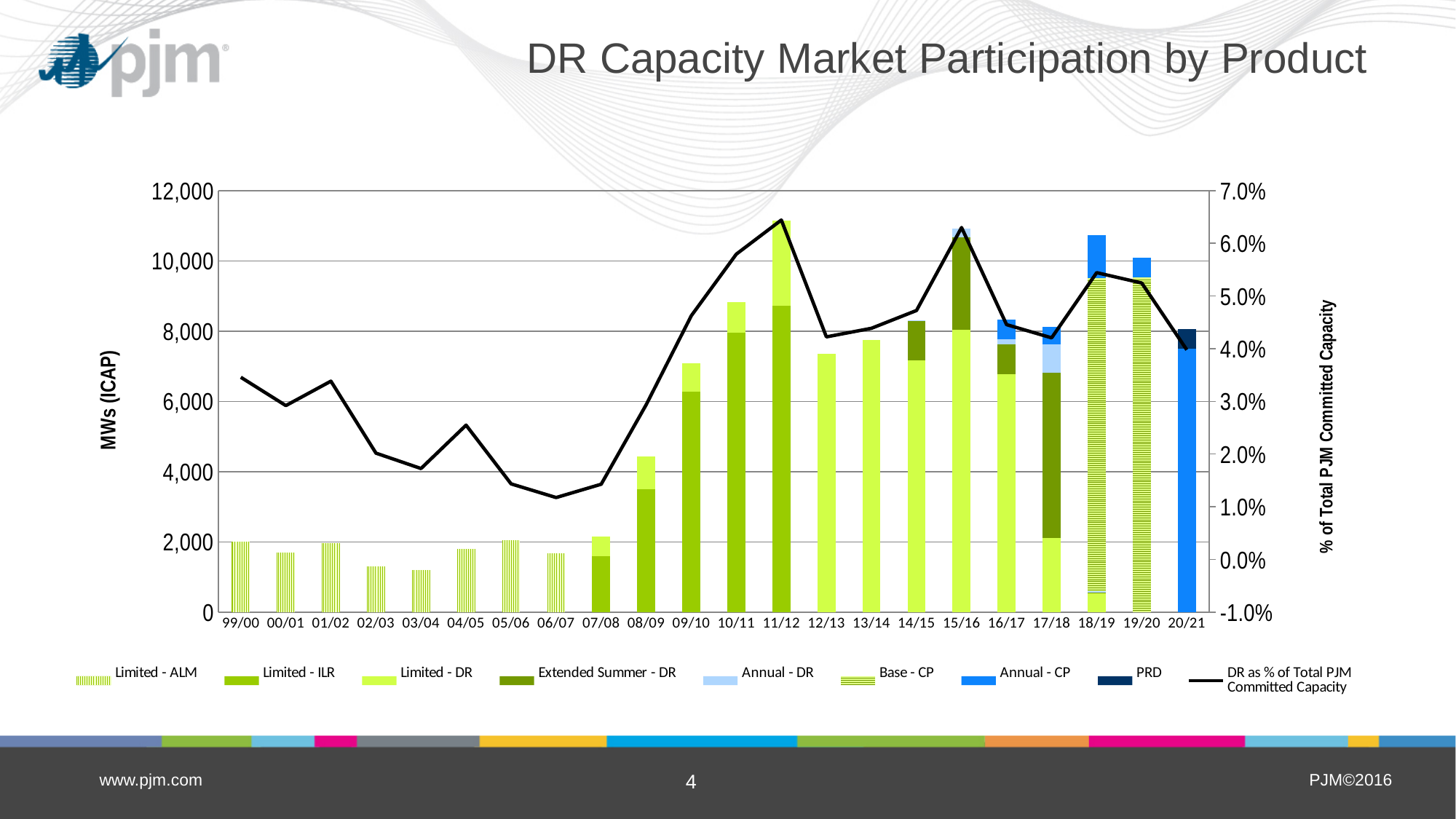
Do the total bar heights rise or fall from 07/08 to 11/12? rise How many series does the legend list? 9 What kind of chart is shown on the slide? Stacked bar chart with a line Which delivery year has the taller total bar, 09/10 or 10/11? 10/11 In which delivery year does the DR as % of Total PJM Committed Capacity line reach its lowest point? 06/07 In which delivery year does the DR as % of Total PJM Committed Capacity line reach its highest point? 11/12 Is the DR as % of Total PJM Committed Capacity line value for 06/07 greater or less than 2.0%? less What is the label of the left vertical axis? MWs (ICAP) Is the total bar height for 12/13 greater or less than 8,000 MWs? less How many delivery-year categories are shown on the x axis? 22 Is the total bar height for 08/09 greater or less than 4,000 MWs? greater